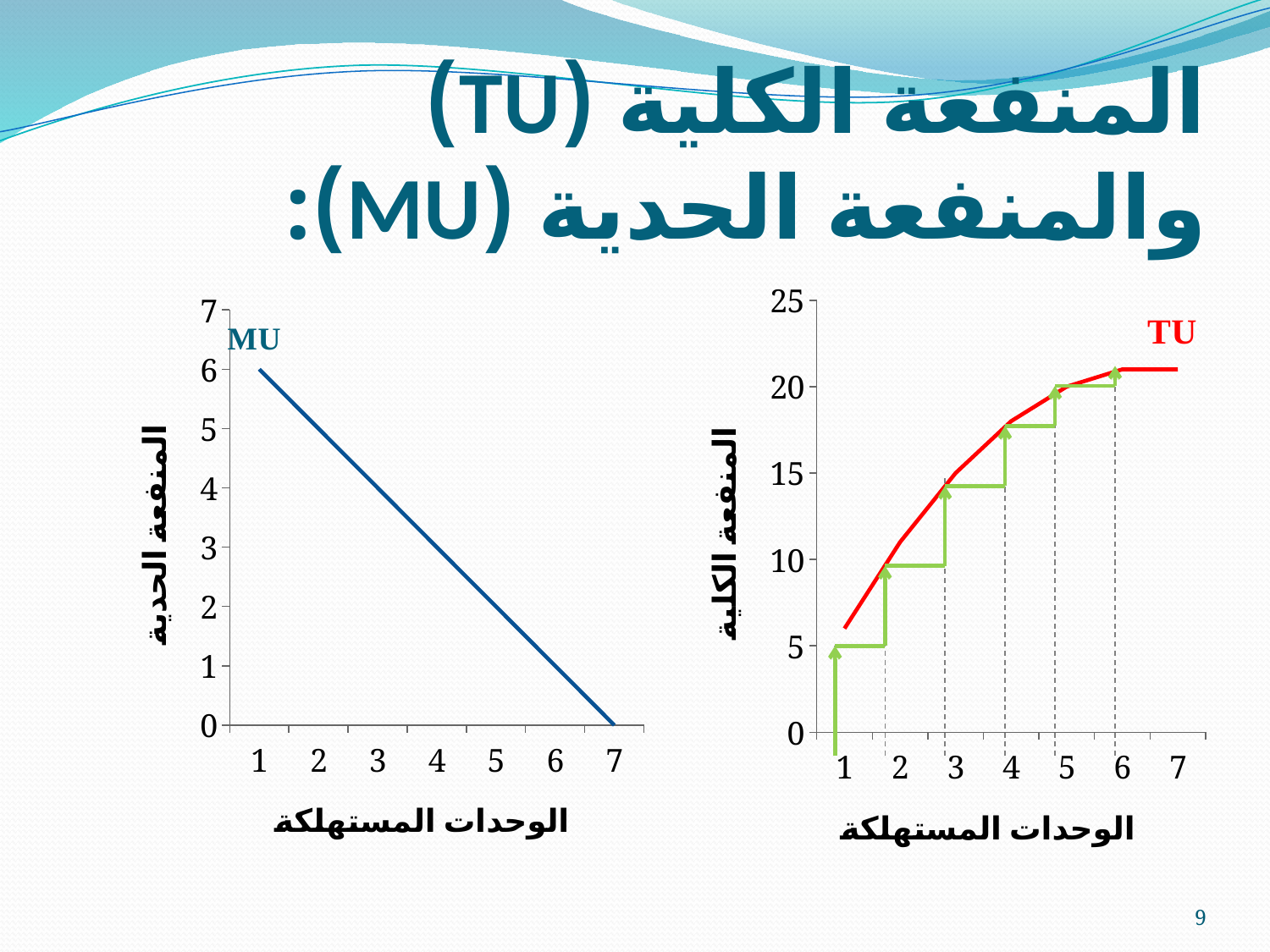
In the MU chart on the left, what is the value of MU at 7 units consumed? 0 In the TU chart on the right, is the value of TU at 1 unit consumed greater or less than 10? less In the MU chart on the left, do the values rise or fall as the number of units consumed increases along the x axis? fall In the MU chart on the left, at which number of units consumed is MU highest? 1 What colour is the TU line in the chart on the right of the slide? red What kind of chart is the MU chart on the left of the slide? line chart What kind of chart is the TU chart on the right of the slide? line chart In the TU chart on the right, is the value of TU at 7 units consumed greater or less than 20? greater In the MU chart on the left, at which number of units consumed is MU lowest? 7 In the MU chart on the left, what is the value of MU at 1 unit consumed? 6 In the TU chart on the right, do the values rise or fall as the number of units consumed increases along the x axis? rise In the TU chart on the right, which is larger: TU at 2 units consumed or TU at 5 units consumed? TU at 5 units consumed